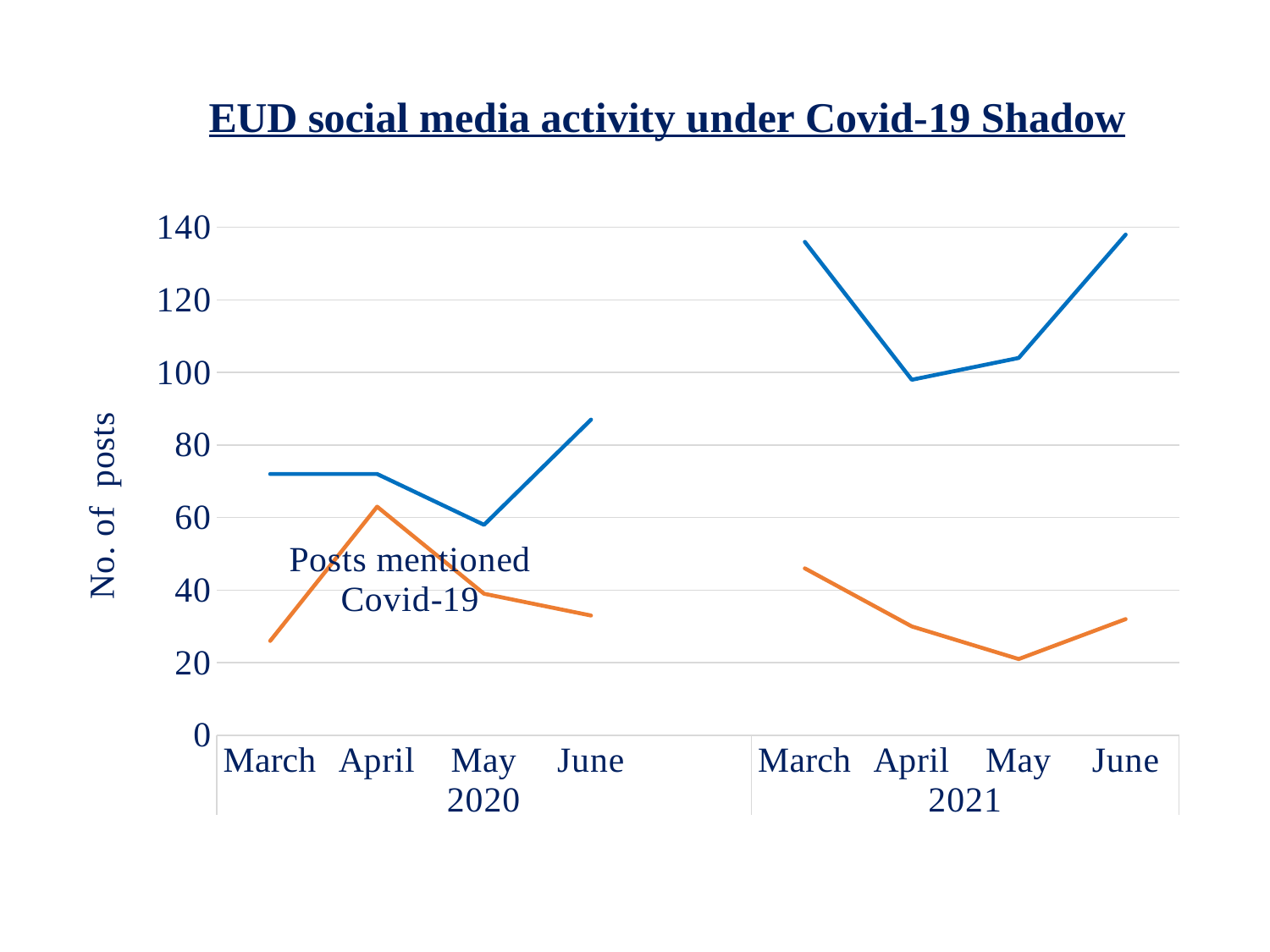
Is the value of the blue line for June 2021 greater or less than 120? greater In which month does the orange line (Posts mentioned Covid-19) reach its highest value? April 2020 Is the value of the orange line (Posts mentioned Covid-19) for March 2020 greater or less than 40? less In which month is the blue line at its lowest? May 2020 Does the orange line (Posts mentioned Covid-19) rise or fall from March 2021 to May 2021? fall Which is larger for the blue line: the value for June 2020 or the value for March 2020? June 2020 Is the value of the blue line for March 2020 greater or less than 60? greater What is the title of the chart? EUD social media activity under Covid-19 Shadow What is the label on the vertical axis? No. of posts How many months are plotted along the x axis in total? 8 What kind of chart is shown on the slide? line chart